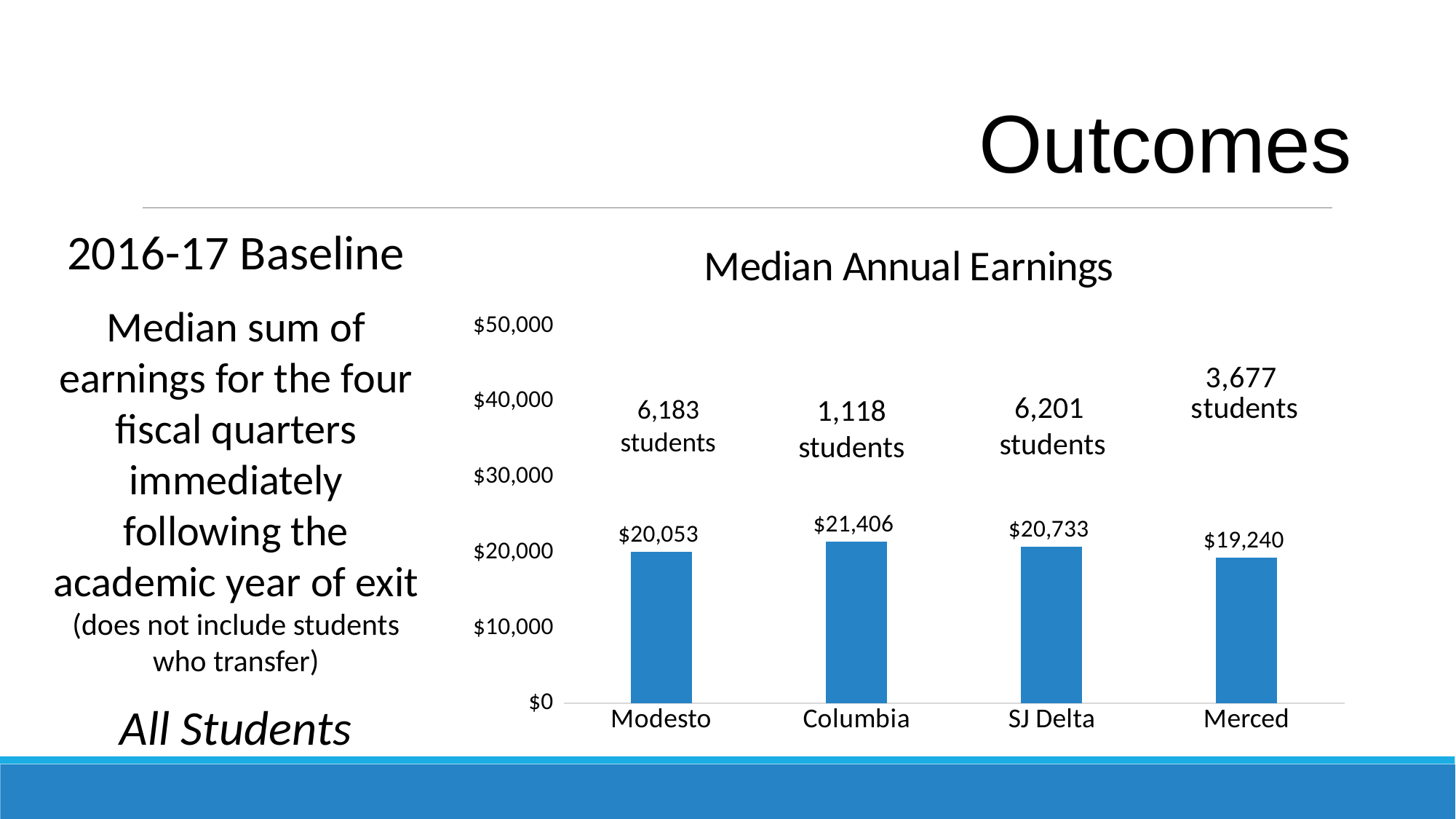
How many colleges are shown on the chart? 4 What is the median annual earnings value for Columbia? $21,406 What is the median annual earnings value for Modesto? $20,053 What is the difference between the median annual earnings for Columbia and Merced? $2,166 What is the median annual earnings value for Merced? $19,240 Which college has the highest median annual earnings? Columbia Is the value for Merced greater or less than $20,000? less What is the median annual earnings value for SJ Delta? $20,733 How many students are noted above the SJ Delta bar? 6,201 students Which has higher median annual earnings, Modesto or SJ Delta? SJ Delta What kind of chart is shown on the slide? Bar chart Which college has the lowest median annual earnings? Merced